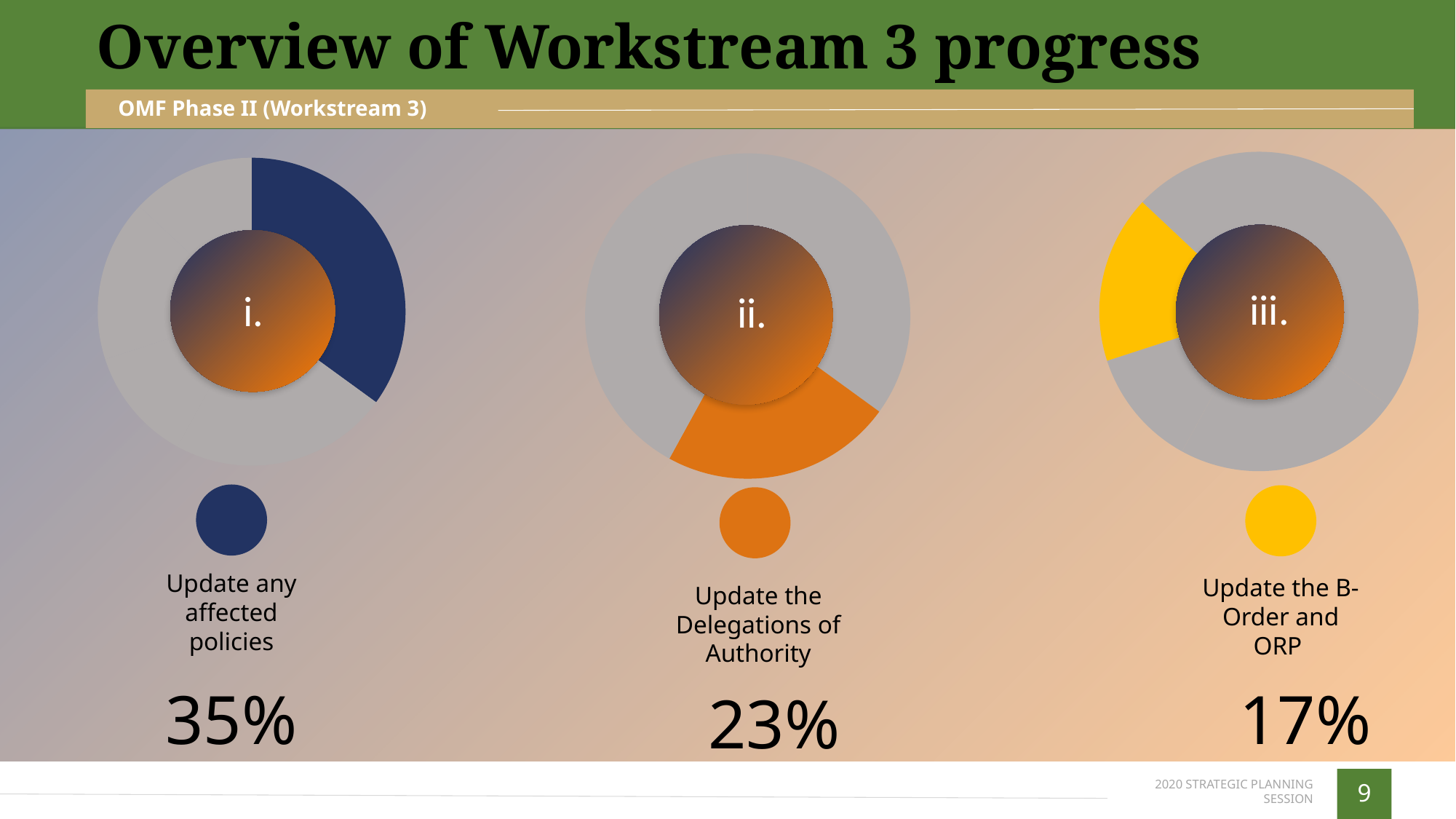
Which shows a larger percentage: the 'Update any affected policies' chart or the 'Update the B-Order and ORP' chart? Update any affected policies What kind of chart is used to show the progress of each workstream item? donut chart What percentage is shown for the chart labelled 'Update any affected policies'? 35% Which of the three workstream items shows the highest progress percentage? Update any affected policies What percentage is shown for the chart labelled 'Update the Delegations of Authority'? 23% What colour is the filled segment in the chart labelled 'i.' (Update any affected policies)? navy blue What is the difference in percentage points between the 'Update the Delegations of Authority' chart and the 'Update the B-Order and ORP' chart? 6 What percentage is shown for the chart labelled 'Update the B-Order and ORP'? 17% What is the difference in percentage points between the 'Update any affected policies' chart and the 'Update the Delegations of Authority' chart? 12 What colour is the filled segment in the chart labelled 'iii.' (Update the B-Order and ORP)? yellow Which of the three workstream items shows the lowest progress percentage? Update the B-Order and ORP How many progress charts are shown on the slide? 3